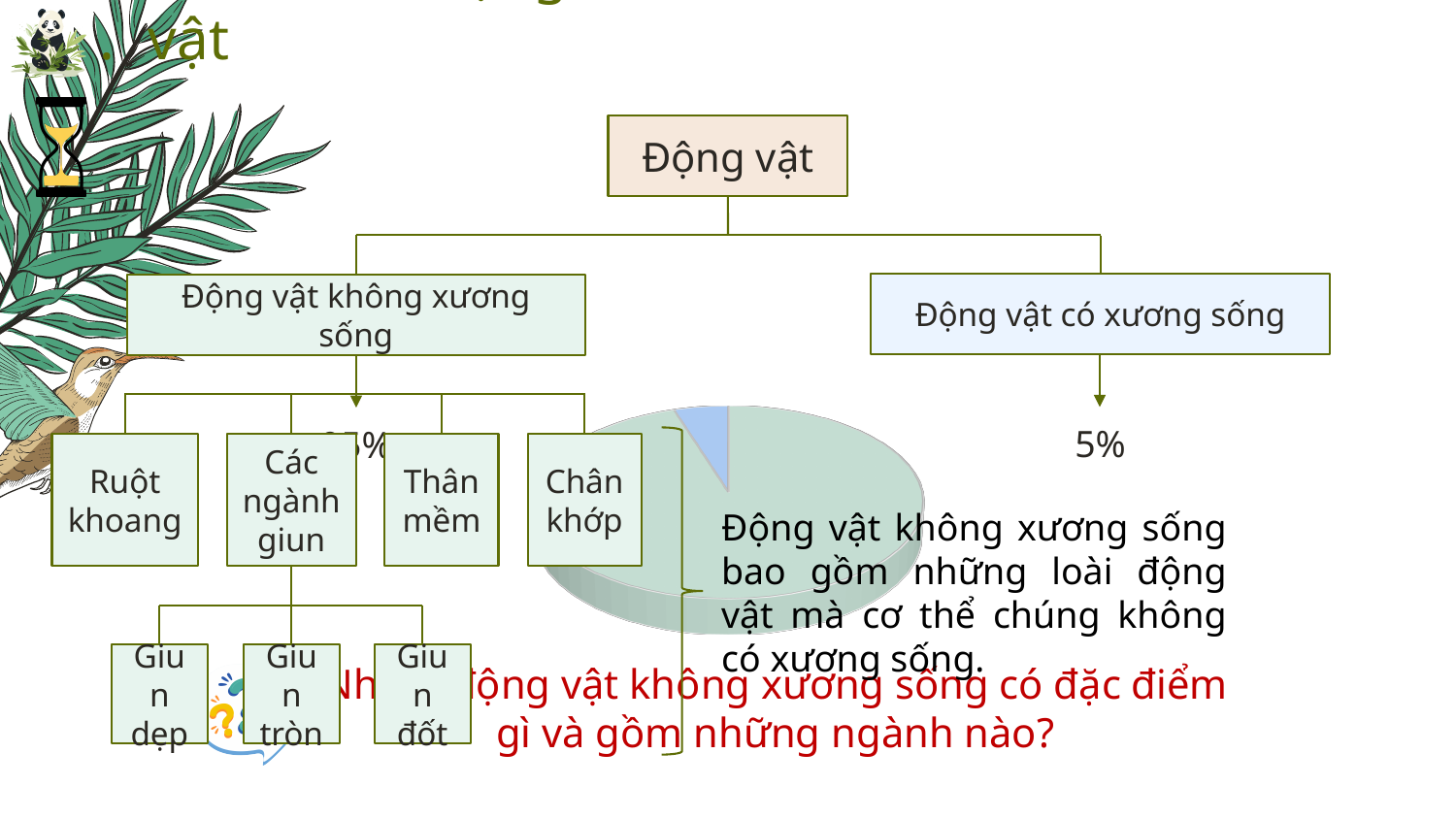
How many slices does the pie chart have? 2 What colour is the small slice of the pie chart? blue Which group has the larger slice of the pie chart, Động vật không xương sống or Động vật có xương sống? Động vật không xương sống What percentage is shown for Động vật có xương sống? 5% What kind of chart is shown on the slide? pie chart Is the share for Động vật có xương sống greater or less than 50%? less Which group has the smallest slice of the pie chart? Động vật có xương sống What colour is the large slice of the pie chart? green